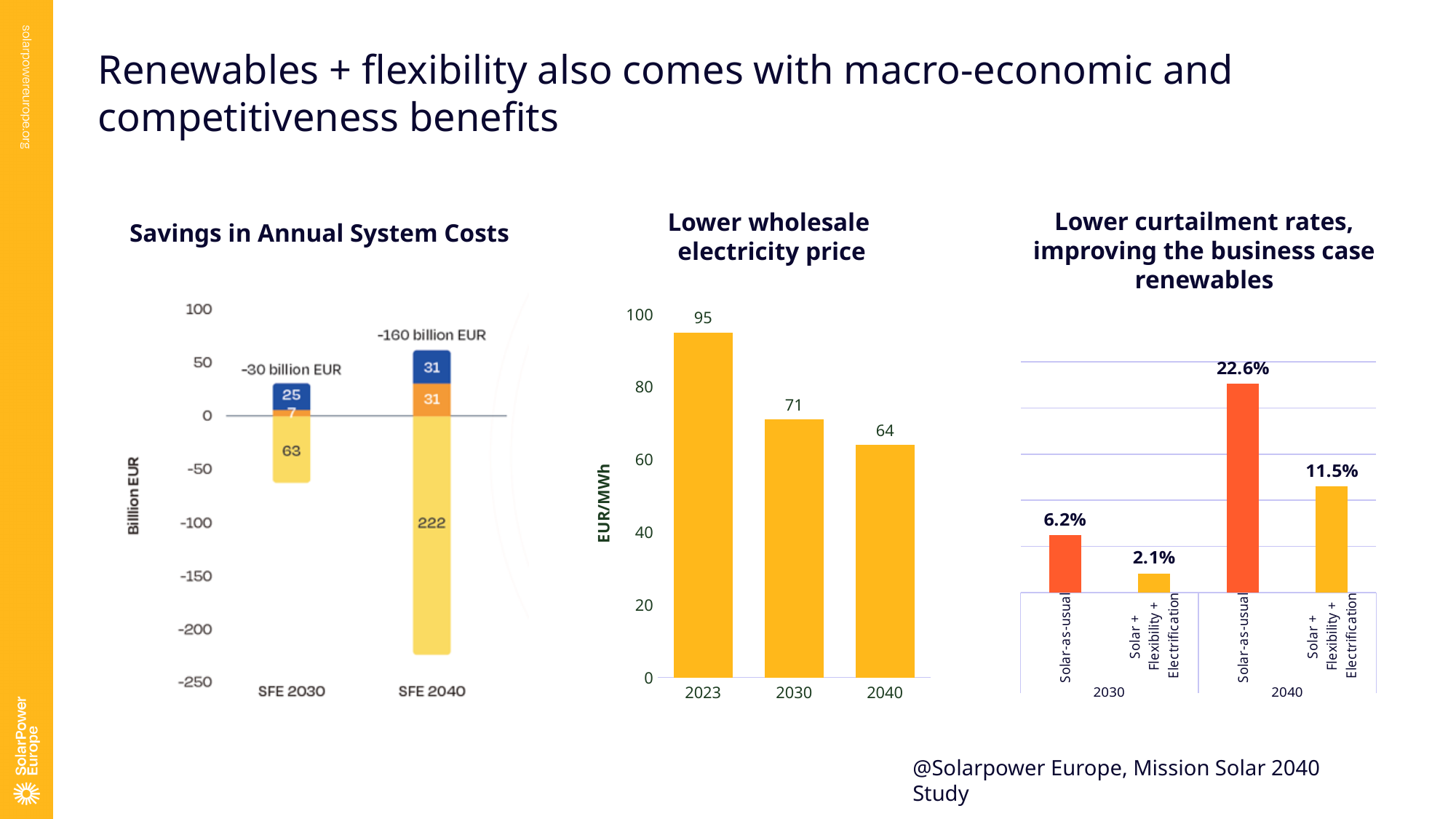
In the 'Lower curtailment rates' chart, what is the curtailment rate for Solar + Flexibility + Electrification in 2030? 2.1% In the 'Lower wholesale electricity price' chart, what is the difference between the 2023 and 2030 values? 24 In the 'Savings in Annual System Costs' chart, what is the value of the largest negative segment in the SFE 2040 bar? 222 In the 'Lower wholesale electricity price' chart, do the values rise or fall from 2023 to 2040? fall In the 'Lower curtailment rates' chart, which bar has the lowest value? Solar + Flexibility + Electrification, 2030 In the 'Lower wholesale electricity price' chart, what is the value for 2040? 64 In the 'Lower curtailment rates' chart, how many bars are plotted? 4 In the 'Lower curtailment rates' chart, what is the difference between Solar-as-usual and Solar + Flexibility + Electrification in 2040? 11.1% In the 'Lower wholesale electricity price' chart, what unit is shown on the vertical axis? EUR/MWh In the 'Lower wholesale electricity price' chart, what is the value for 2023? 95 In the 'Lower curtailment rates' chart, what is the curtailment rate for Solar-as-usual in 2040? 22.6% In the 'Savings in Annual System Costs' chart, what is the net saving labelled above the SFE 2040 bar? -160 billion EUR